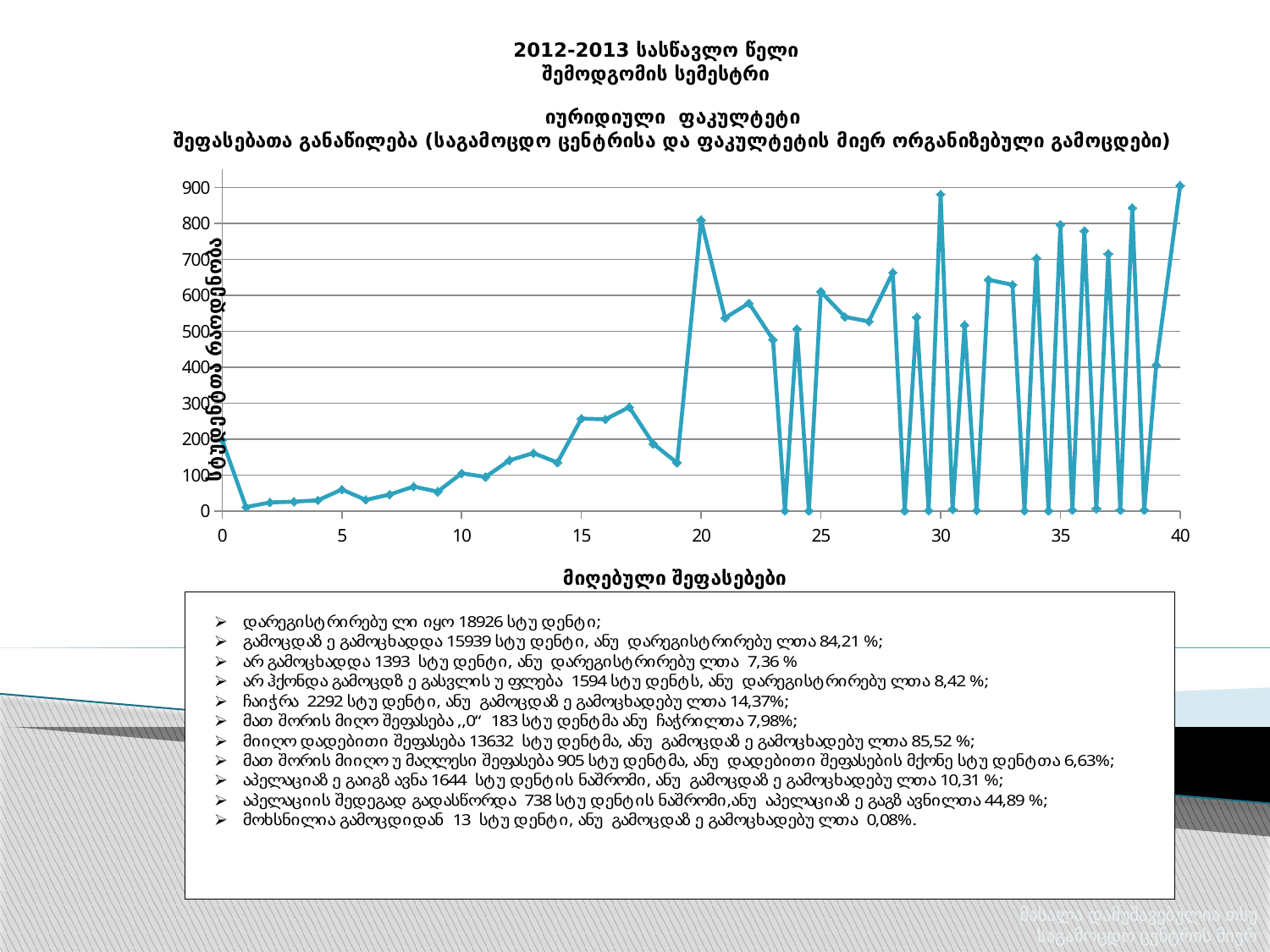
Is the value at x = 30 greater or less than 800? greater Do the values generally rise or fall along the x axis between x = 1 and x = 17? rise Which is larger, the value at x = 25 or the value at x = 15? x = 25 What kind of chart is shown on the slide? line chart Is the value at x = 10 greater or less than 200? less Is the value at x = 25 greater or less than 500? greater What is the label on the vertical axis of the chart? სტუდენტთა რაოდენობა What is the label on the horizontal axis of the chart? მიღებული შეფასებები Which is larger, the value at x = 20 or the value at x = 10? x = 20